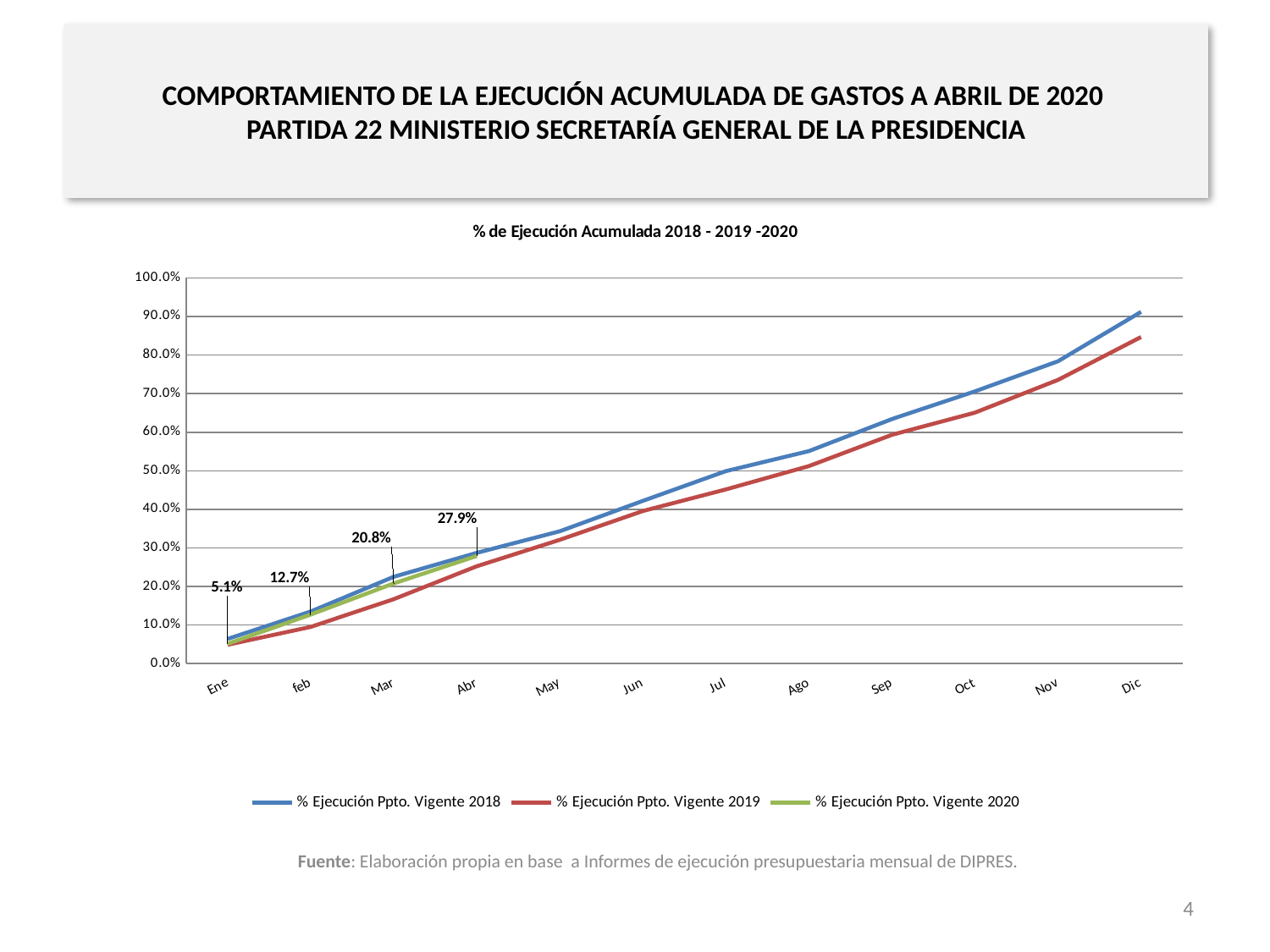
What is the difference between the 2020 values for Abr and Mar? 7.1% How many months are shown on the x axis? 12 What is the value for % Ejecución Ppto. Vigente 2020 in Mar? 20.8% Which series has the higher value in Dic, % Ejecución Ppto. Vigente 2018 or % Ejecución Ppto. Vigente 2019? % Ejecución Ppto. Vigente 2018 What kind of chart is shown on the slide? Line chart What is the value for % Ejecución Ppto. Vigente 2020 in Abr? 27.9% How many series does the legend list? 3 What is the value for % Ejecución Ppto. Vigente 2020 in Ene? 5.1% What is the value for % Ejecución Ppto. Vigente 2020 in feb? 12.7% Is the value for % Ejecución Ppto. Vigente 2019 in Dic greater or less than 80.0%? greater Is the value for % Ejecución Ppto. Vigente 2019 in Mar greater or less than 20.0%? less What is the difference between the 2020 values for feb and Ene? 7.6%